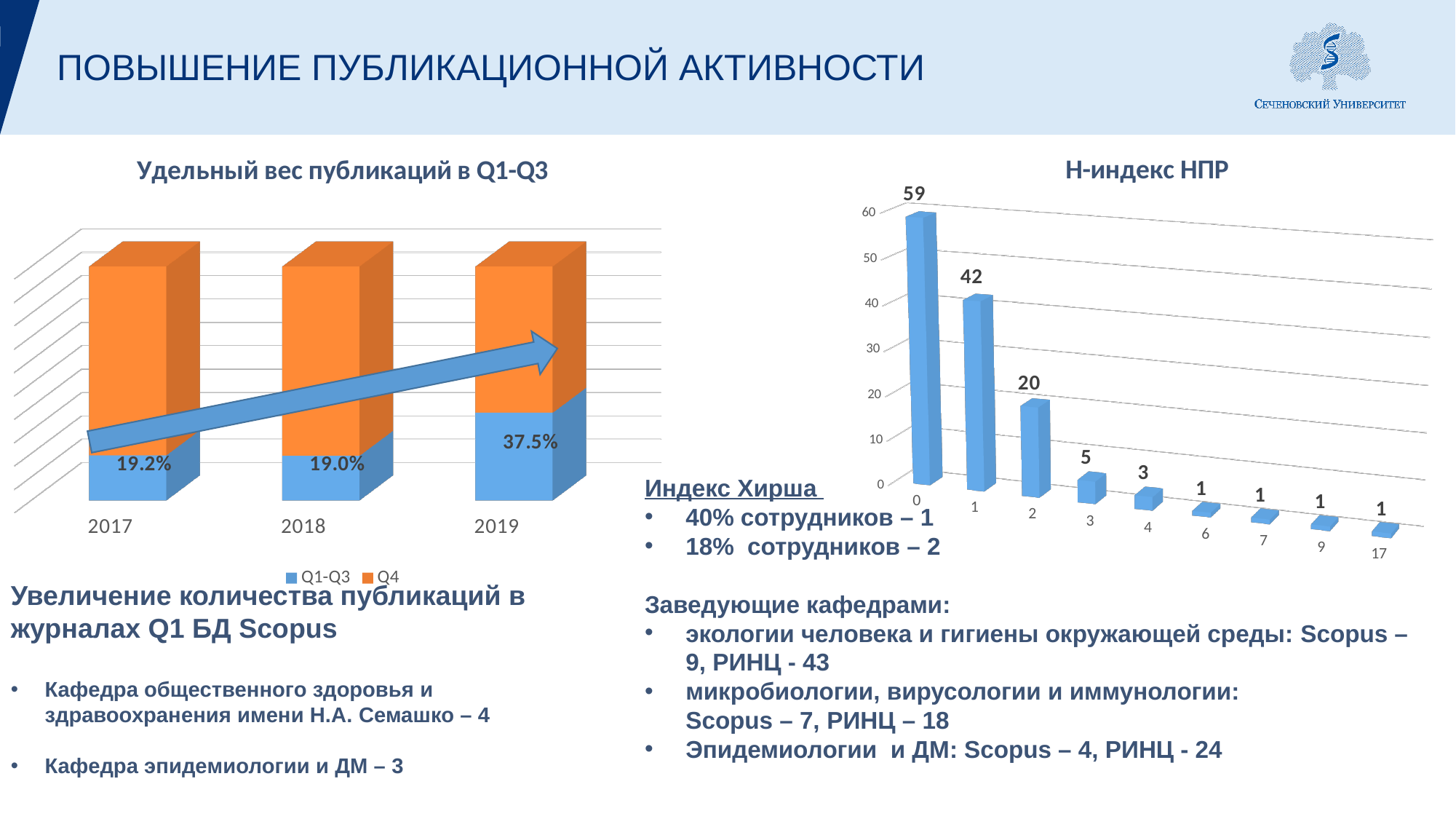
In the chart 'H-индекс НПР', what is the difference between the values for categories 0 and 1? 17 In the chart 'Удельный вес публикаций в Q1-Q3', which series is shown in orange? Q4 In the chart 'H-индекс НПР', what is the value for category 2? 20 In the chart 'H-индекс НПР', which category has the highest value? 0 In the chart 'H-индекс НПР', what is the value for category 1? 42 In the chart 'Удельный вес публикаций в Q1-Q3', what is the difference between the Q1-Q3 values for 2019 and 2018? 18.5% In the chart 'Удельный вес публикаций в Q1-Q3', what is the Q1-Q3 value for 2019? 37.5% In the chart 'H-индекс НПР', do the values rise or fall along the x axis? fall In the chart 'H-индекс НПР', how many categories are shown on the x axis? 9 In the chart 'Удельный вес публикаций в Q1-Q3', how many series does the legend list? 2 In the chart 'Удельный вес публикаций в Q1-Q3', what is the Q1-Q3 value for 2017? 19.2% In the chart 'Удельный вес публикаций в Q1-Q3', which year has the highest Q1-Q3 share? 2019